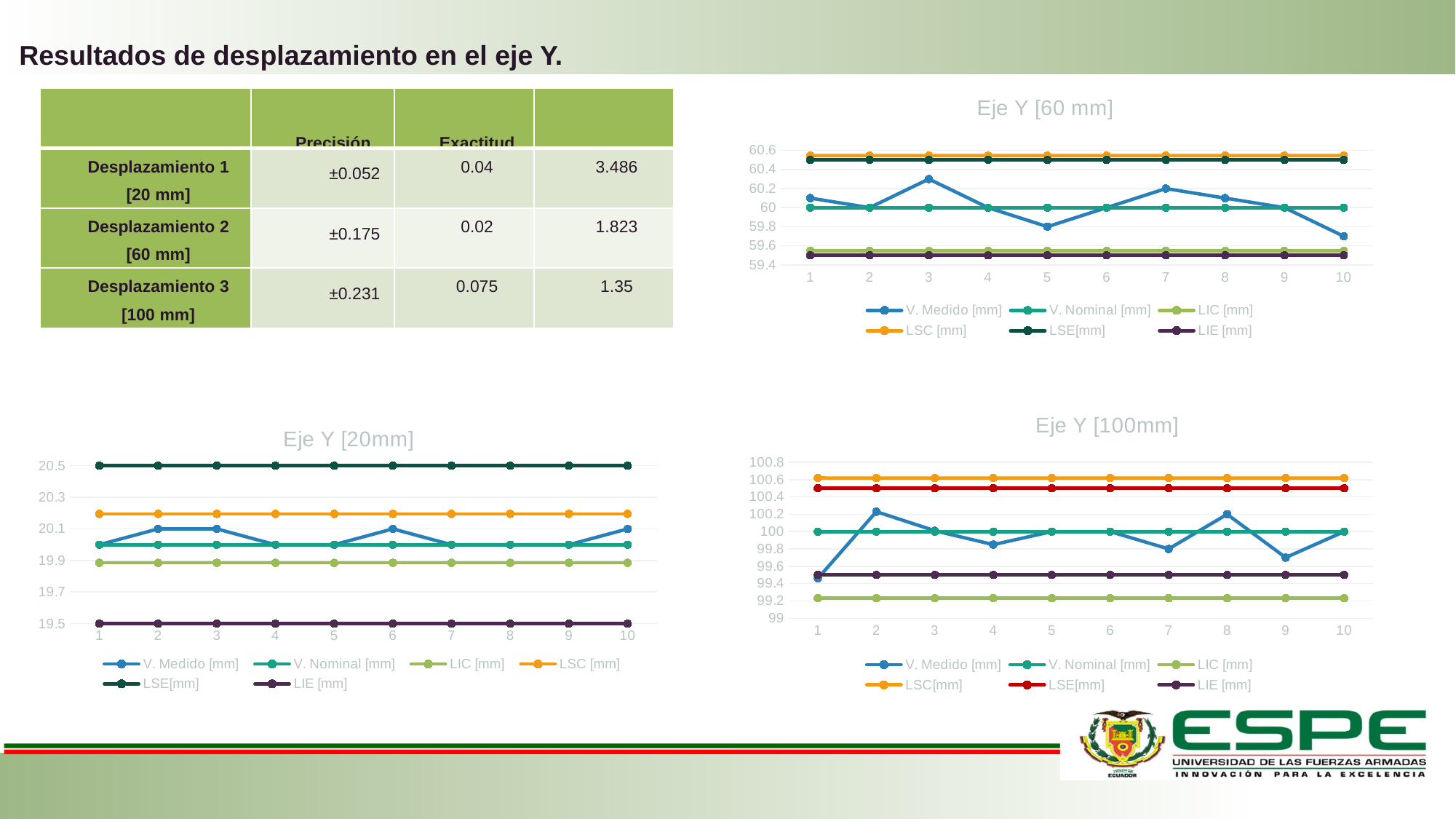
In the "Eje Y [100mm]" chart, which series is higher, LSC[mm] or LSE[mm]? LSC[mm] In the "Eje Y [60 mm]" chart, what is the V. Medido [mm] value at point 5? 59.8 In the "Eje Y [100mm]" chart, is the V. Medido [mm] value at point 1 greater or less than 99.6? less What kind of chart is the "Eje Y [60 mm]" chart? line chart What is the title of the chart in the bottom-left of the slide? Eje Y [20mm] How many series does the legend of the "Eje Y [20mm]" chart list? 6 In the "Eje Y [60 mm]" chart, what is the value of the V. Nominal [mm] series? 60 In the "Eje Y [60 mm]" chart, is the V. Medido [mm] value at point 3 greater or less than 60.2? greater In the "Eje Y [20mm]" chart, what is the value of the LSE[mm] series? 20.5 How many points are plotted along the x axis of the "Eje Y [100mm]" chart for each series? 10 In the "Eje Y [100mm]" chart, what is the V. Nominal [mm] value? 100 In the "Eje Y [20mm]" chart, what is the value of the LIE [mm] series? 19.5